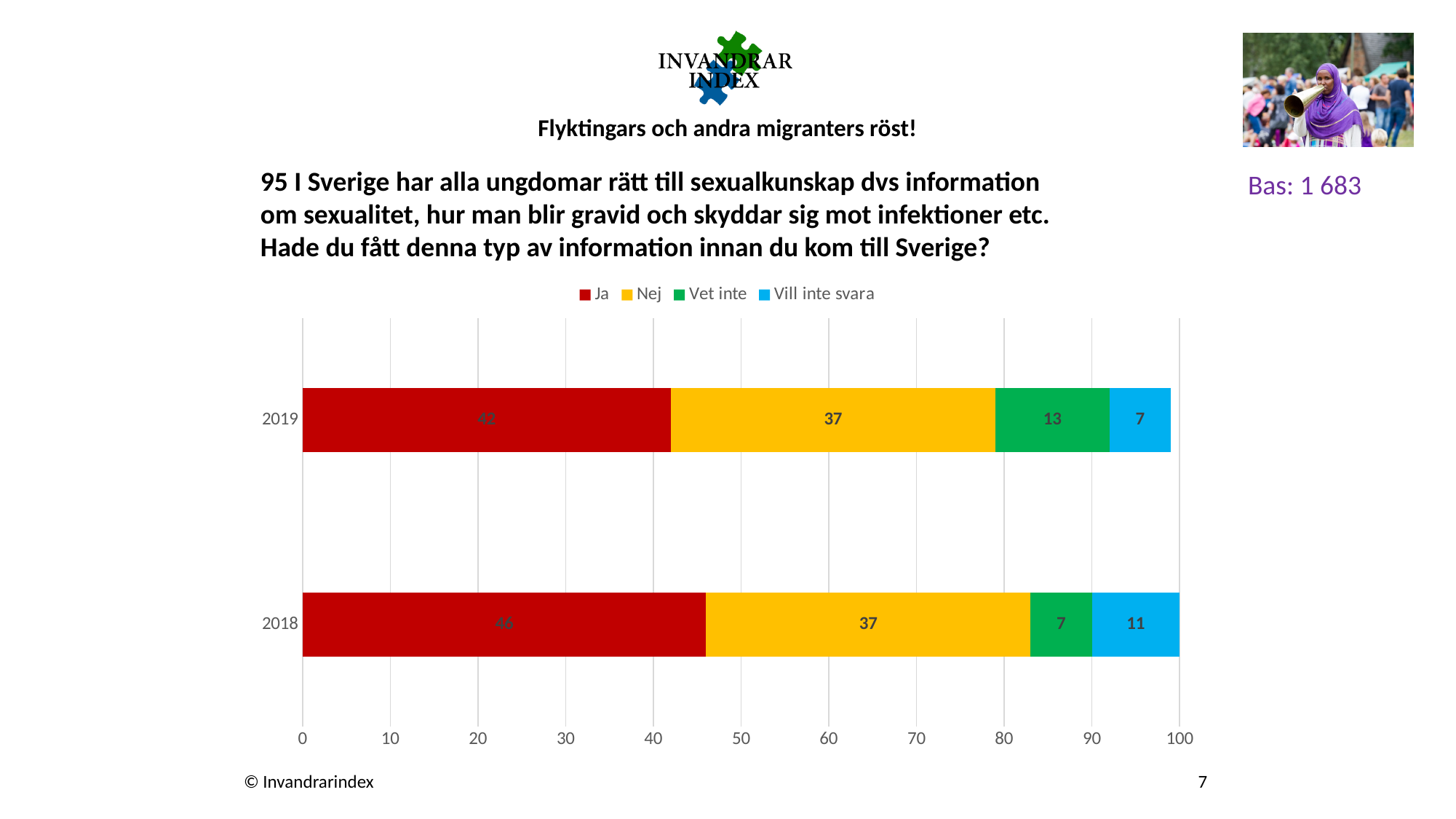
What is the value for Vill inte svara in 2018? 11 What is the total of the stacked bar for 2018? 101 What is the value for Vet inte in 2019? 13 How many categories (years) are shown on the chart? 2 What is the difference between the Ja values for 2018 and 2019? 4 What is the total of the stacked bar for 2019? 99 What is the value for Ja in 2019? 42 Which year has the higher value for Ja? 2018 How many series does the legend list? 4 What is the difference between the Vet inte values for 2019 and 2018? 6 What is the value for Nej in 2018? 37 What kind of chart is shown on the slide? Stacked bar chart